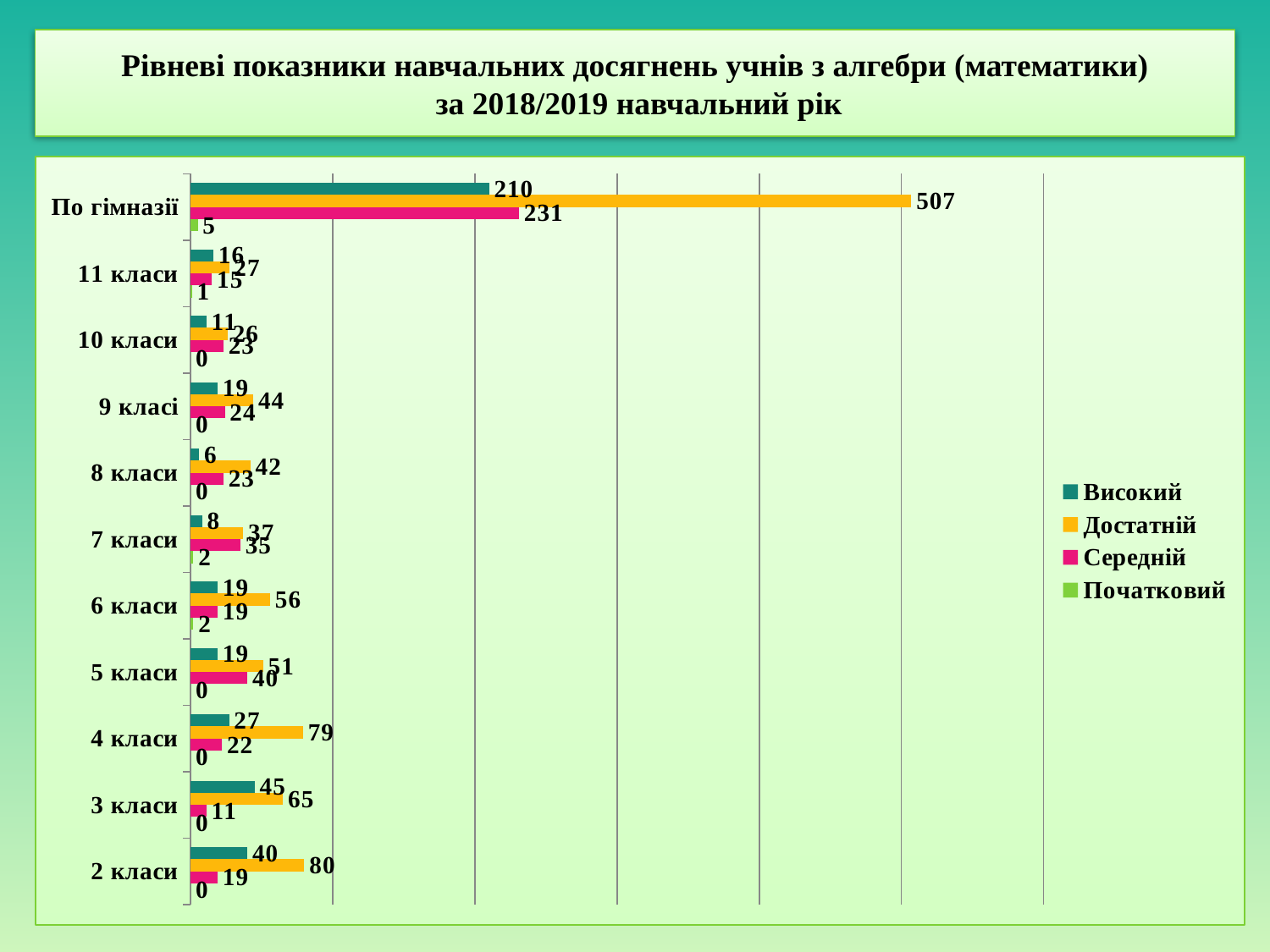
How many series does the legend list? 4 What is the value of Достатній for По гімназії? 507 What is the value of Початковий for 11 класи? 1 What is the value of Високий for 3 класи? 45 Which is larger for 7 класи: the Достатній value or the Середній value? Достатній Among the class categories (excluding По гімназії), which has the highest Достатній value? 2 класи What is the difference between the Достатній values for 4 класи and 3 класи? 14 How many categories are shown on the vertical axis? 11 What type of chart is shown on the slide? Bar chart Which series is shown in pink/magenta in the legend? Середній What is the value of Середній for 5 класи? 40 Among the class categories (excluding По гімназії), which has the lowest Високий value? 8 класи